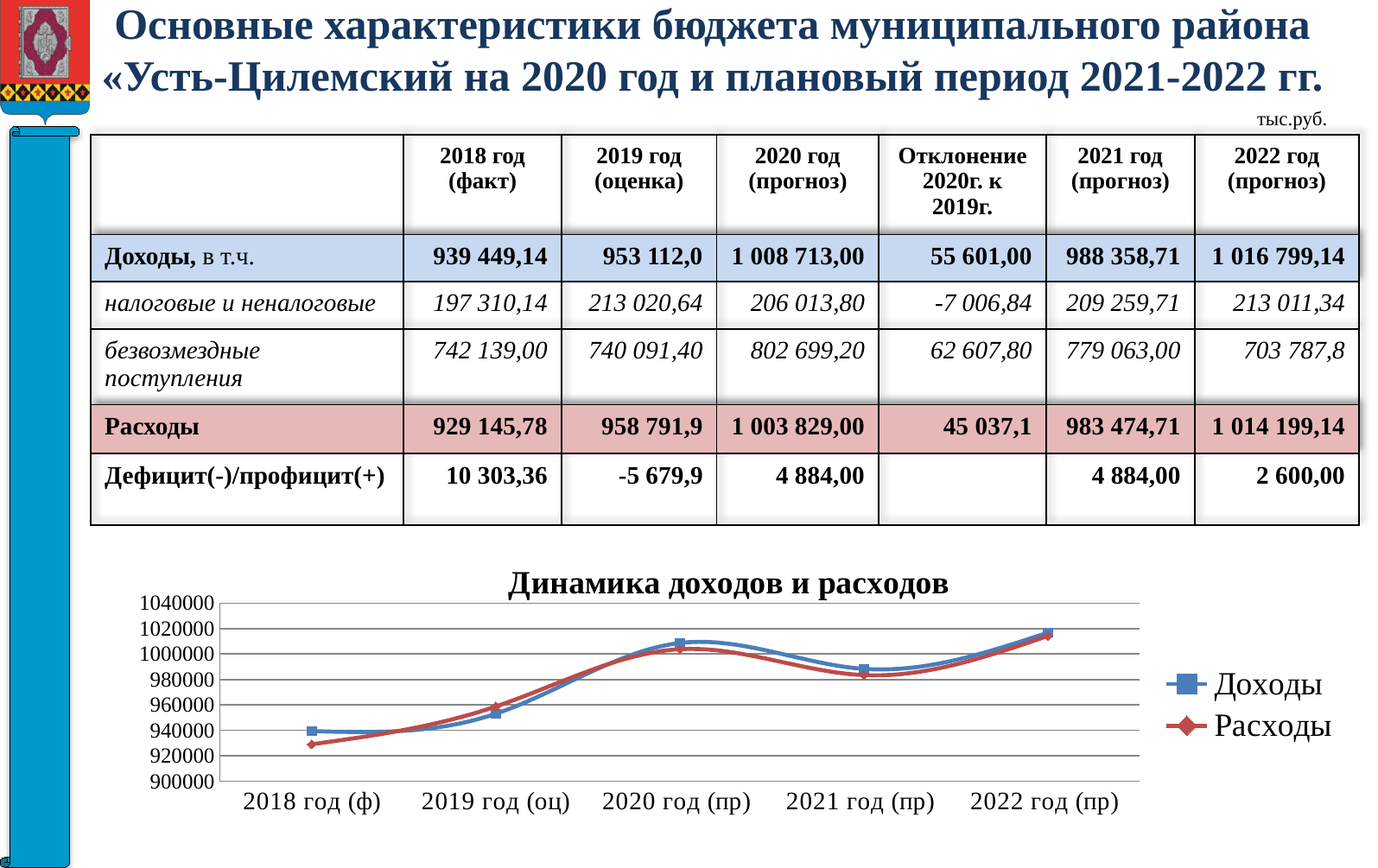
In the chart "Динамика доходов и расходов", which series is shown with a blue line and square markers? Доходы In the chart "Динамика доходов и расходов", is the value of Доходы for 2020 год (пр) greater or less than 1000000? greater In the chart "Динамика доходов и расходов", at which x-axis point is the Доходы series lowest? 2018 год (ф) In the chart "Динамика доходов и расходов", do the Доходы values rise or fall from 2018 год (ф) to 2020 год (пр)? rise In the chart "Динамика доходов и расходов", is the value of Доходы for 2018 год (ф) greater or less than 960000? less In the chart "Динамика доходов и расходов", is the value of Расходы for 2018 год (ф) greater or less than 940000? less In the chart "Динамика доходов и расходов", which is larger for 2018 год (ф): Доходы or Расходы? Доходы In the chart "Динамика доходов и расходов", at which x-axis point is the Расходы series highest? 2022 год (пр) How many series does the legend of the chart "Динамика доходов и расходов" list? 2 What kind of chart is shown under the title "Динамика доходов и расходов"? line chart How many points along the x axis does the chart "Динамика доходов и расходов" have? 5